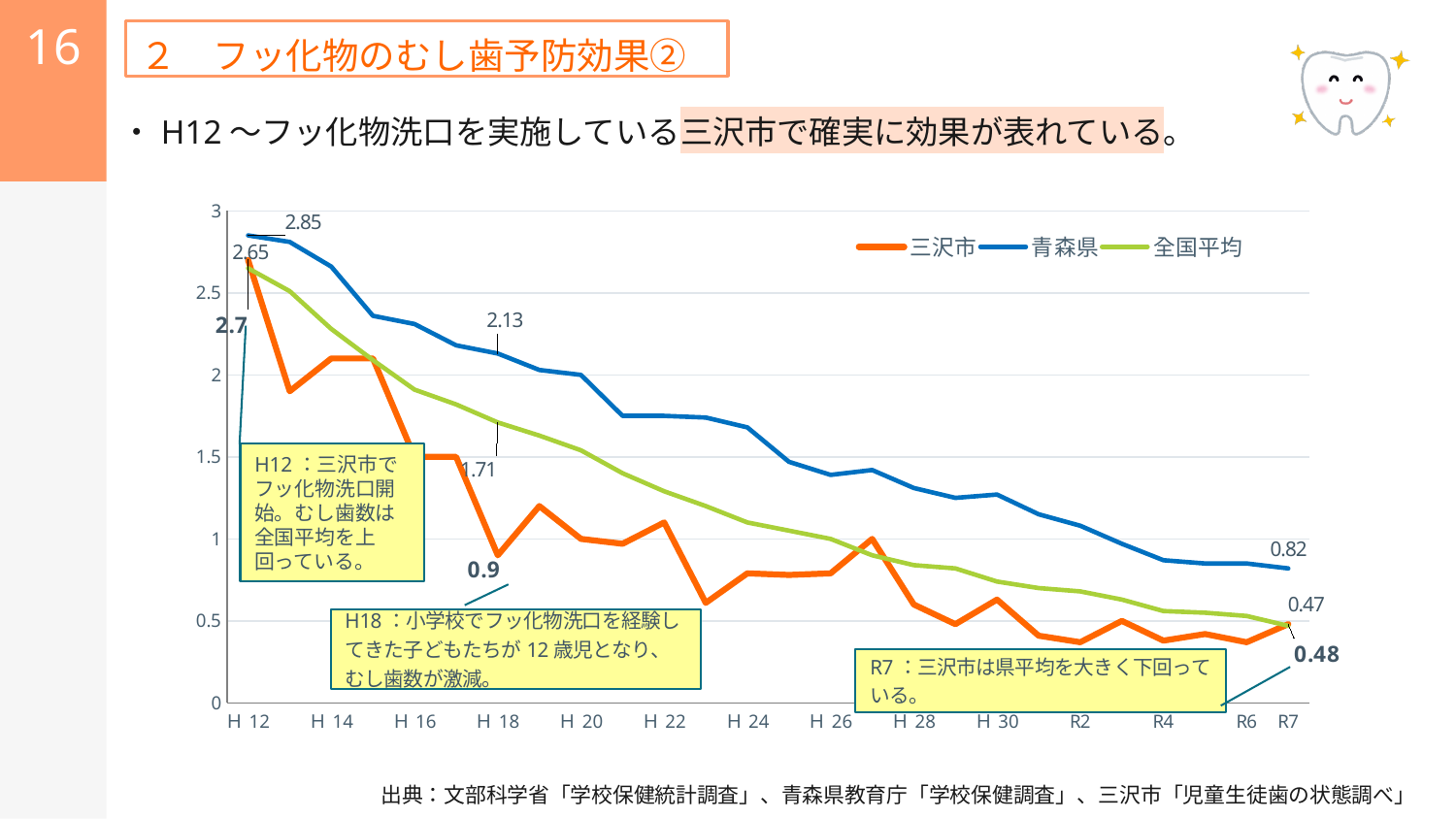
How many series does the chart legend list? 3 What is the value for 全国平均 at H12? 2.65 What is the value for 全国平均 at R7? 0.47 Is the value for 青森県 at H24 greater or less than 1.5? greater What is the value for 青森県 at H12? 2.85 Which series has the highest value at H12? 青森県 What is the value for 三沢市 at H18? 0.9 What is the difference between the 青森県 value and the 三沢市 value at R7? 0.34 Does the 三沢市 line rise or fall overall from H12 to R7? fall What is the value for 青森県 at R7? 0.82 What kind of chart is shown on the slide? line chart What is the value for 三沢市 at H12? 2.7